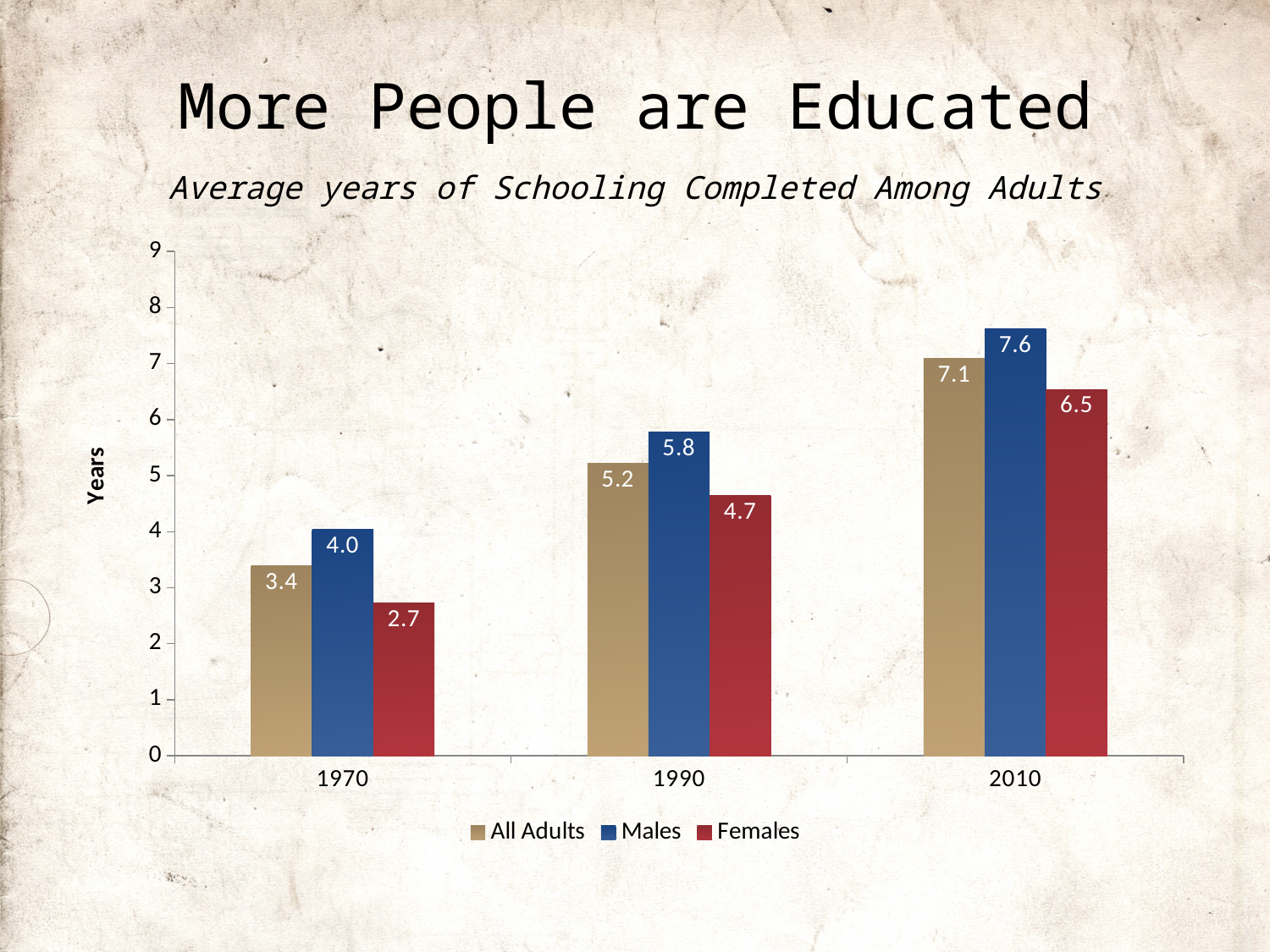
What is the value for Females in 1970? 2.7 Do the values for Males rise or fall from 1970 to 2010? rise Which is larger in 1990: the value for All Adults or the value for Females? All Adults Which year has the lowest value for All Adults? 1970 What is the difference between the Males and Females values in 2010? 1.1 Is the value for Males in 2010 greater or less than 7? greater What is the value for All Adults in 2010? 7.1 Which year has the highest value for Females? 2010 How many series does the legend list? 3 What is the value for Males in 1990? 5.8 How many years are shown on the x axis? 3 What kind of chart is shown on the slide? bar chart